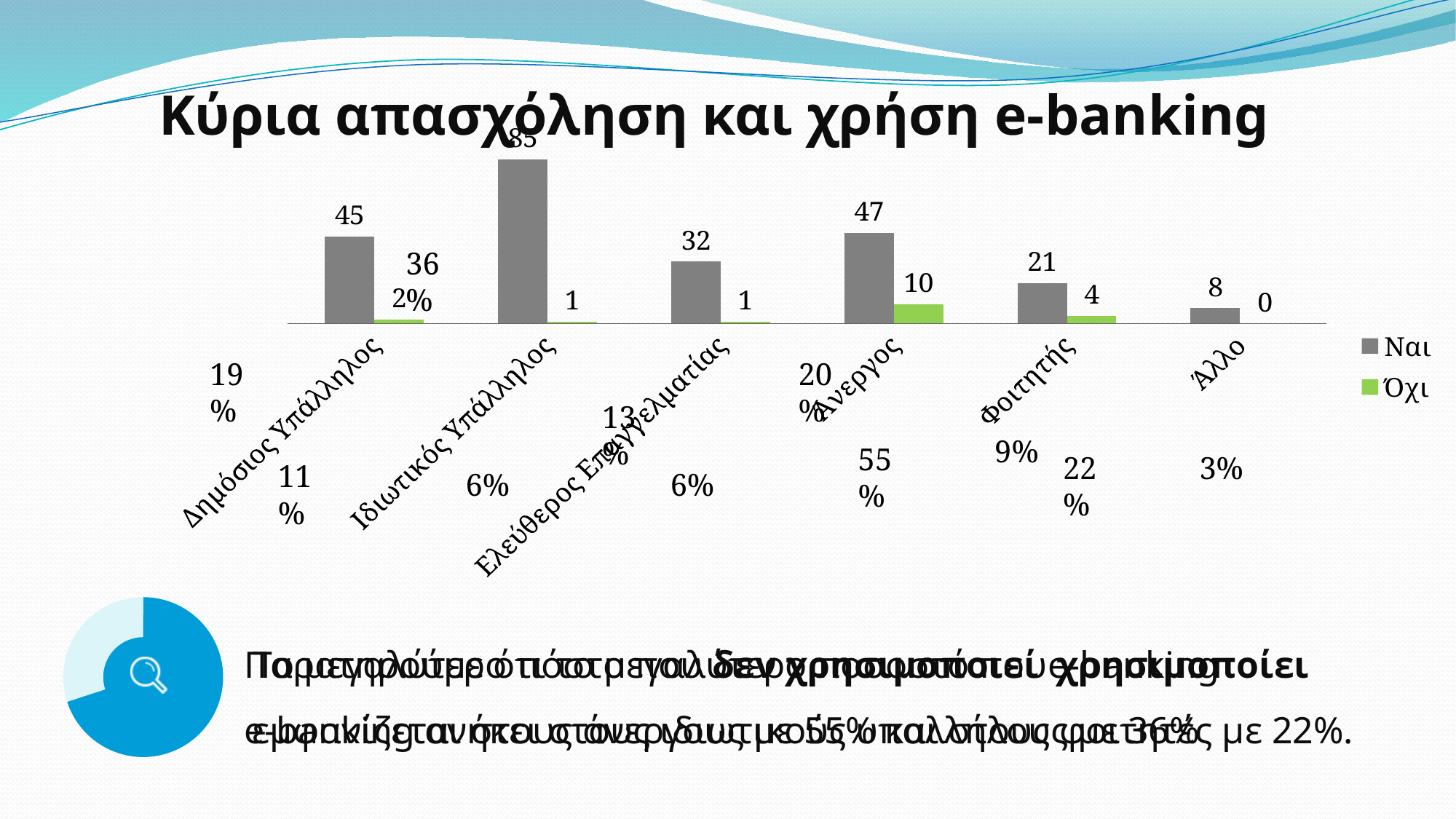
What is the value of the Ναι series for Δημόσιος Υπάλληλος? 45 What is the value of the Όχι series for Άνεργος? 10 What is the value of the Ναι series for Άνεργος? 47 Which is larger: the Όχι value for Άνεργος or the Όχι value for Φοιτητής? Άνεργος Which category has the highest value in the Ναι series? Ιδιωτικός Υπάλληλος Which category has the lowest value in the Ναι series? Άλλο What is the value of the Ναι series for Φοιτητής? 21 What is the value of the Όχι series for Άλλο? 0 How many categories are shown on the x axis of the chart? 6 How many series does the legend list? 2 Which category has the highest value in the Όχι series? Άνεργος What is the difference between the Ναι and Όχι values for Φοιτητής? 17